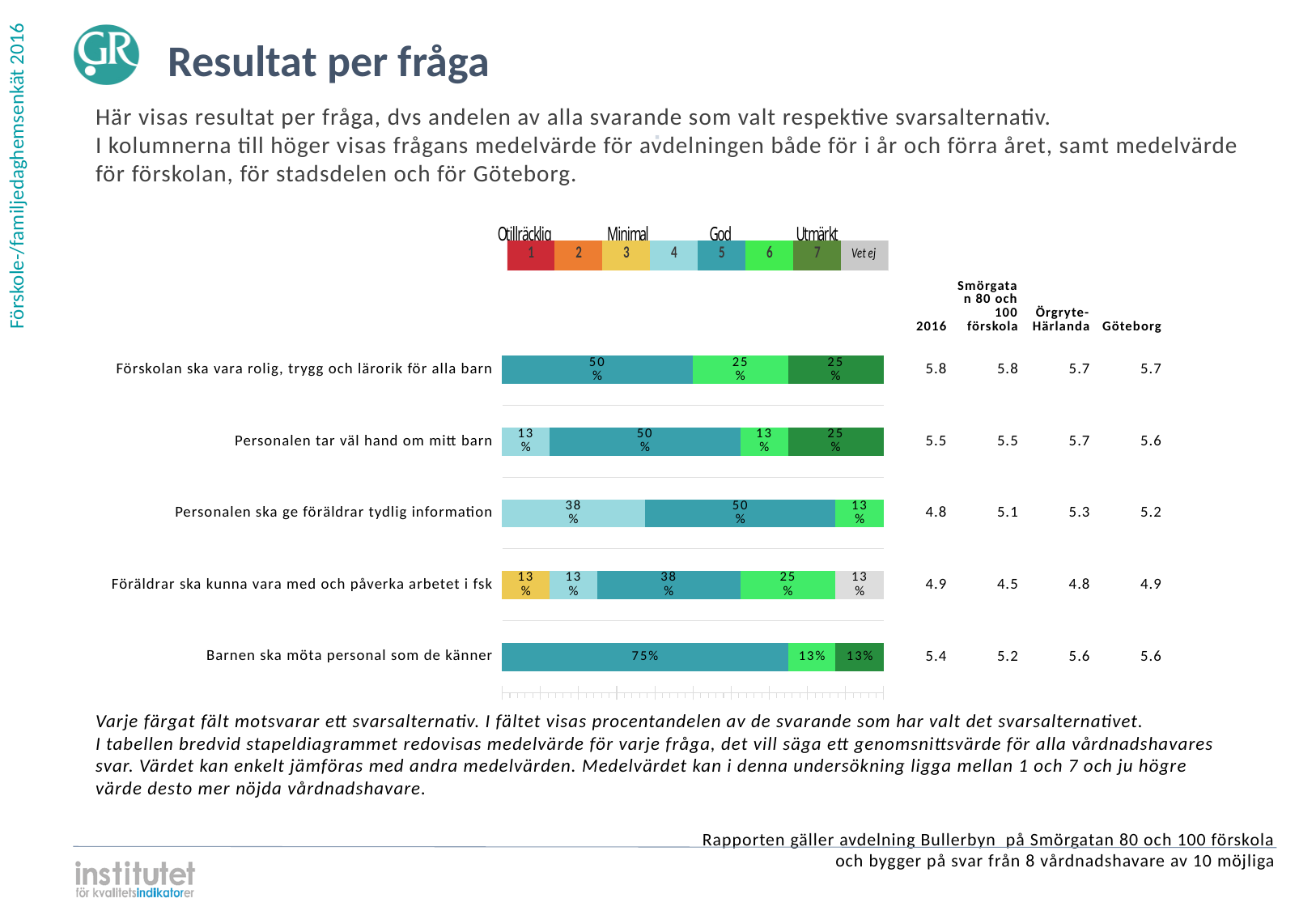
How many questions (categories) are plotted in the bar chart? 5 What is the Göteborg mean value for 'Personalen tar väl hand om mitt barn'? 5.6 Which question has the largest single segment in its bar? Barnen ska möta personal som de känner What percentage of respondents answered 'Vet ej' for 'Föräldrar ska kunna vara med och påverka arbetet i fsk'? 13% How many answer alternatives does the legend above the chart list? 8 What kind of chart is shown on the slide? stacked bar chart What percentage of respondents chose alternative 4 for 'Personalen ska ge föräldrar tydlig information'? 38% What is the difference between the share choosing alternative 5 and the share choosing alternative 6 for 'Barnen ska möta personal som de känner'? 62% What is the 2016 mean value for 'Personalen ska ge föräldrar tydlig information'? 4.8 What percentage of respondents chose alternative 7 for 'Förskolan ska vara rolig, trygg och lärorik för alla barn'? 25% What percentage of respondents chose alternative 5 for 'Barnen ska möta personal som de känner'? 75% For 'Förskolan ska vara rolig, trygg och lärorik för alla barn', which is larger: the share choosing alternative 5 or the share choosing alternative 6? alternative 5